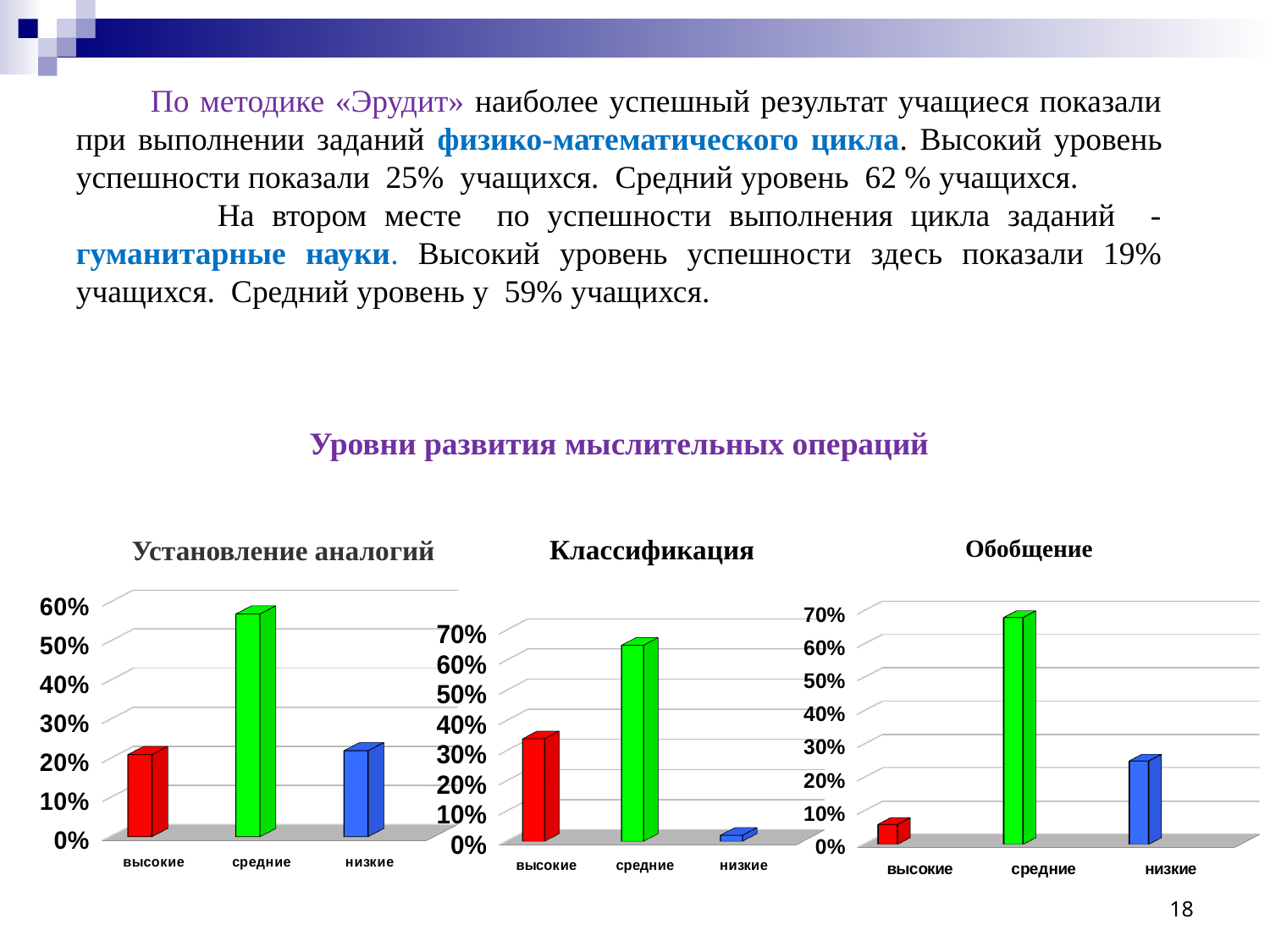
In the chart titled «Классификация», which category has the lowest value? низкие In the chart titled «Обобщение», which category has the highest value? средние In the chart titled «Установление аналогий», is the value for высокие greater or less than 30%? less How many categories are shown in the chart titled «Обобщение»? 3 In the chart titled «Обобщение», which category has the lowest value? высокие In the chart titled «Установление аналогий», is the value for средние greater or less than 50%? greater In the chart titled «Установление аналогий», which category has the highest value? средние In the chart titled «Обобщение», is the value for низкие greater or less than 30%? less What kind of chart is the chart titled «Классификация»? bar chart In the chart titled «Классификация», which is larger, the value for высокие or the value for низкие? высокие